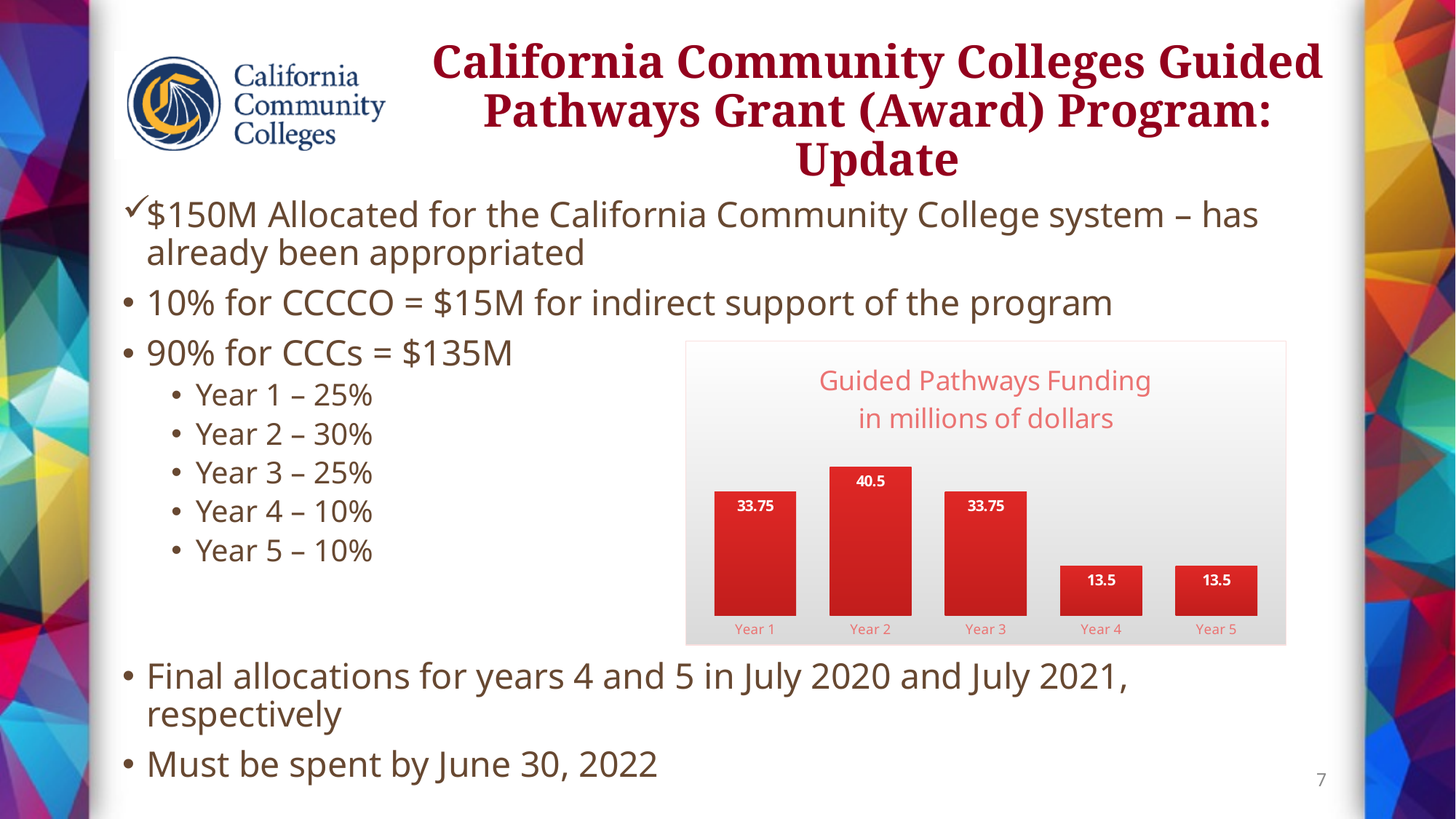
What is the value for Year 2 in the Guided Pathways Funding chart? 40.5 What is the total of all five years in the Guided Pathways Funding chart? 135 What is the difference between the Year 2 and Year 3 values in the Guided Pathways Funding chart? 6.75 What unit does the title of the chart say the funding is measured in? Millions of dollars What is the value for Year 1 in the Guided Pathways Funding chart? 33.75 Which year has the highest funding in the Guided Pathways Funding chart? Year 2 Which is larger in the Guided Pathways Funding chart, Year 2 or Year 5? Year 2 What is the value for Year 4 in the Guided Pathways Funding chart? 13.5 How many years (categories) are shown in the Guided Pathways Funding chart? 5 What kind of chart is the Guided Pathways Funding chart? Bar chart Do the values in the Guided Pathways Funding chart rise or fall from Year 3 to Year 5? Fall What is the difference between the Year 1 and Year 4 values in the Guided Pathways Funding chart? 20.25